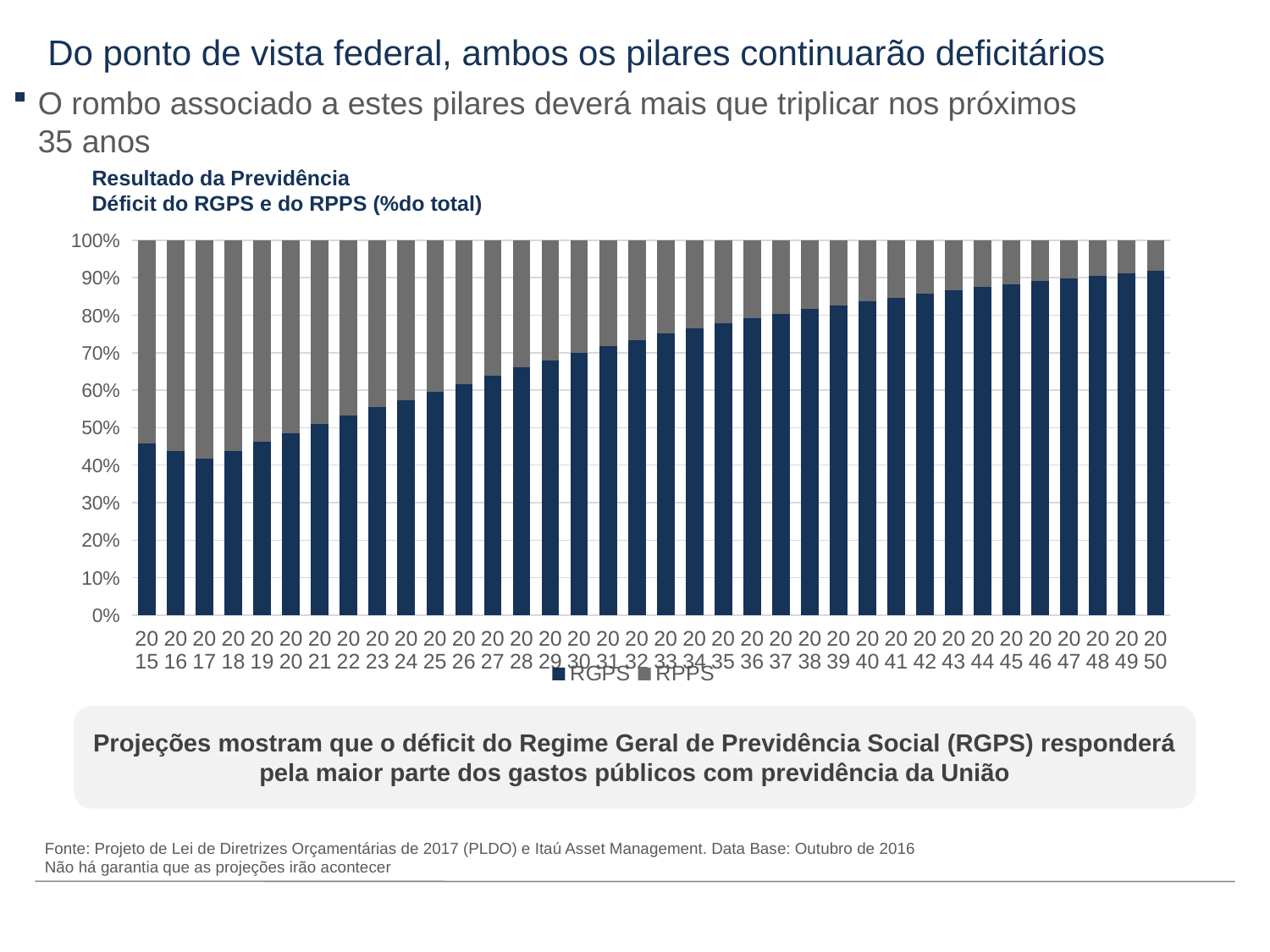
What kind of chart is shown on the slide? stacked bar chart How many series does the legend list? 2 Is the RGPS share in 2040 greater or less than 80%? greater In 2050, which series has the larger share, RGPS or RPPS? RGPS What are the two series named in the legend? RGPS and RPPS Does the RGPS share rise or fall from 2015 to 2050? rise How many years (bars) are plotted in the chart? 36 Is the RGPS share in 2015 greater or less than 50%? less In 2015, which series has the larger share, RGPS or RPPS? RPPS Is the RGPS share in 2050 greater or less than 90%? greater What is the total height of each stacked bar in the chart? 100%